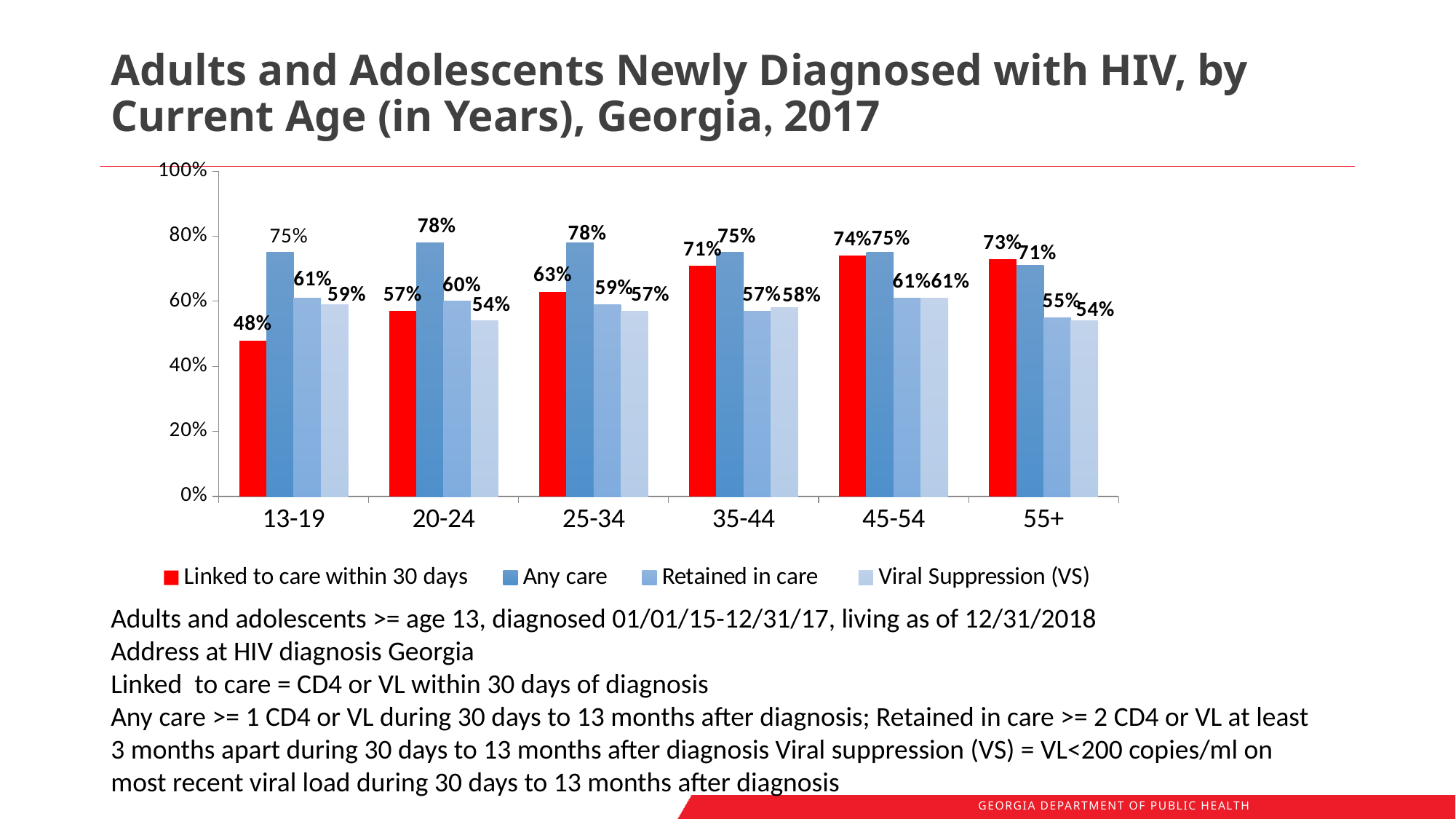
What is the Viral Suppression (VS) value for the 45-54 age group? 61% How many age groups are shown on the x axis? 6 Which age group has the highest value for Linked to care within 30 days? 45-54 How many series does the legend list? 4 What is the Any care value for the 20-24 age group? 78% Does the Linked to care within 30 days value rise or fall from the 13-19 group to the 45-54 group? Rise For the 13-19 age group, what is the difference between the Any care value and the Linked to care within 30 days value? 27 percentage points Which age group has the lowest value for Linked to care within 30 days? 13-19 What percentage of the 13-19 age group was linked to care within 30 days? 48% For the 55+ age group, which is larger: Linked to care within 30 days or Any care? Linked to care within 30 days What colour represents Linked to care within 30 days in the chart? Red What kind of chart is shown on the slide? Bar chart